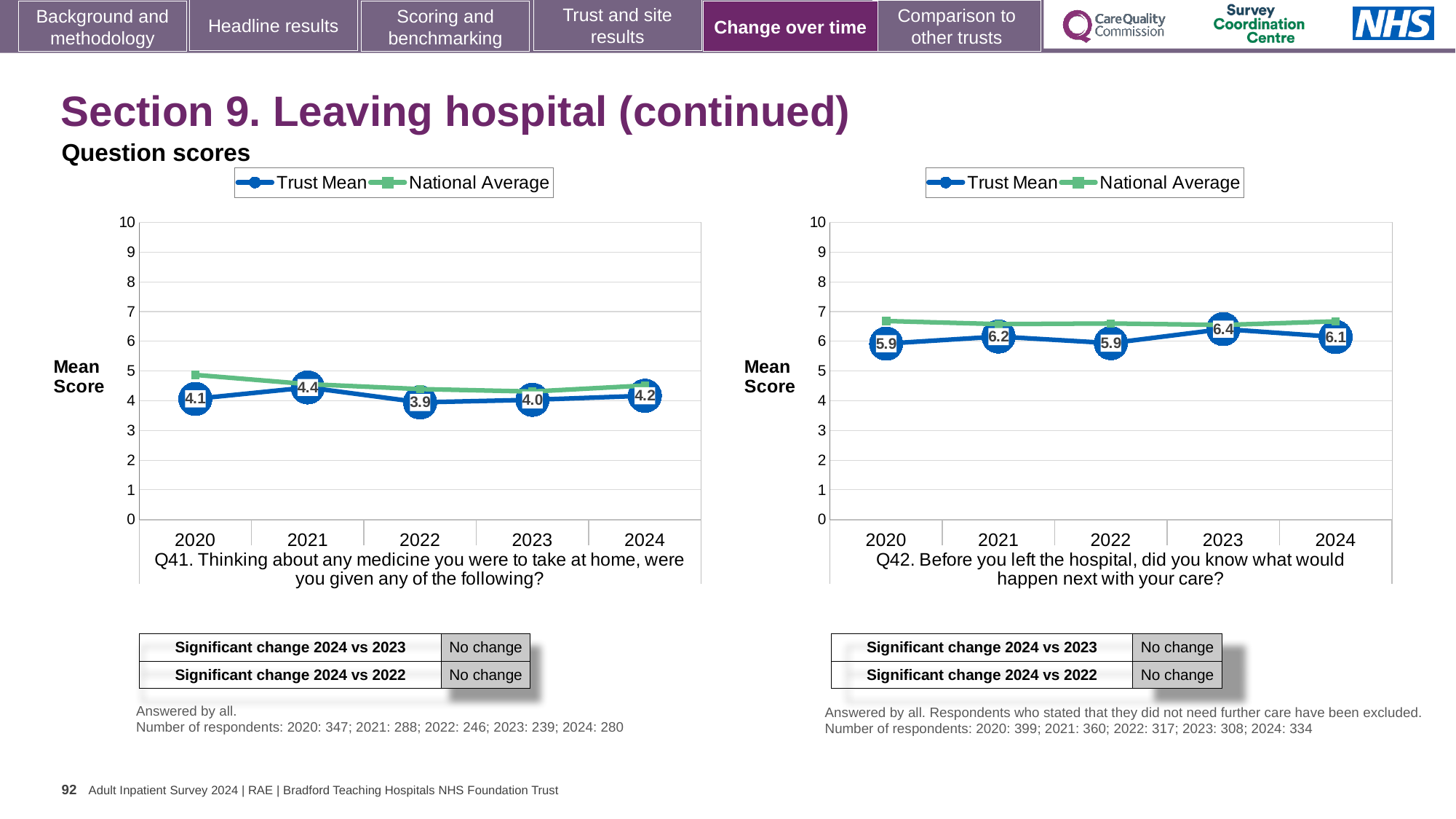
On the Q41 chart (left), what is the difference between the Trust Mean scores for 2021 and 2022? 0.5 On the Q41 chart (left), what is the Trust Mean score for 2021? 4.4 On the Q42 chart (right), is the Trust Mean score for 2021 larger than the Trust Mean score for 2020? Yes On the Q42 chart (right), which year has the highest Trust Mean score? 2023 On the Q42 chart (right), is the National Average for 2020 greater or less than 6? greater On the Q42 chart (right), what is the difference between the Trust Mean scores for 2023 and 2024? 0.3 On the Q41 chart (left), how many years are plotted on the x axis? 5 On the Q41 chart (left), which year has the lowest Trust Mean score? 2022 On the Q41 chart (left), is the National Average for 2020 greater or less than 4? greater How many series does the legend of the Q42 chart (right) list? 2 On the Q42 chart (right), what is the Trust Mean score for 2023? 6.4 What kind of chart is the Q41 chart (left)? Line chart